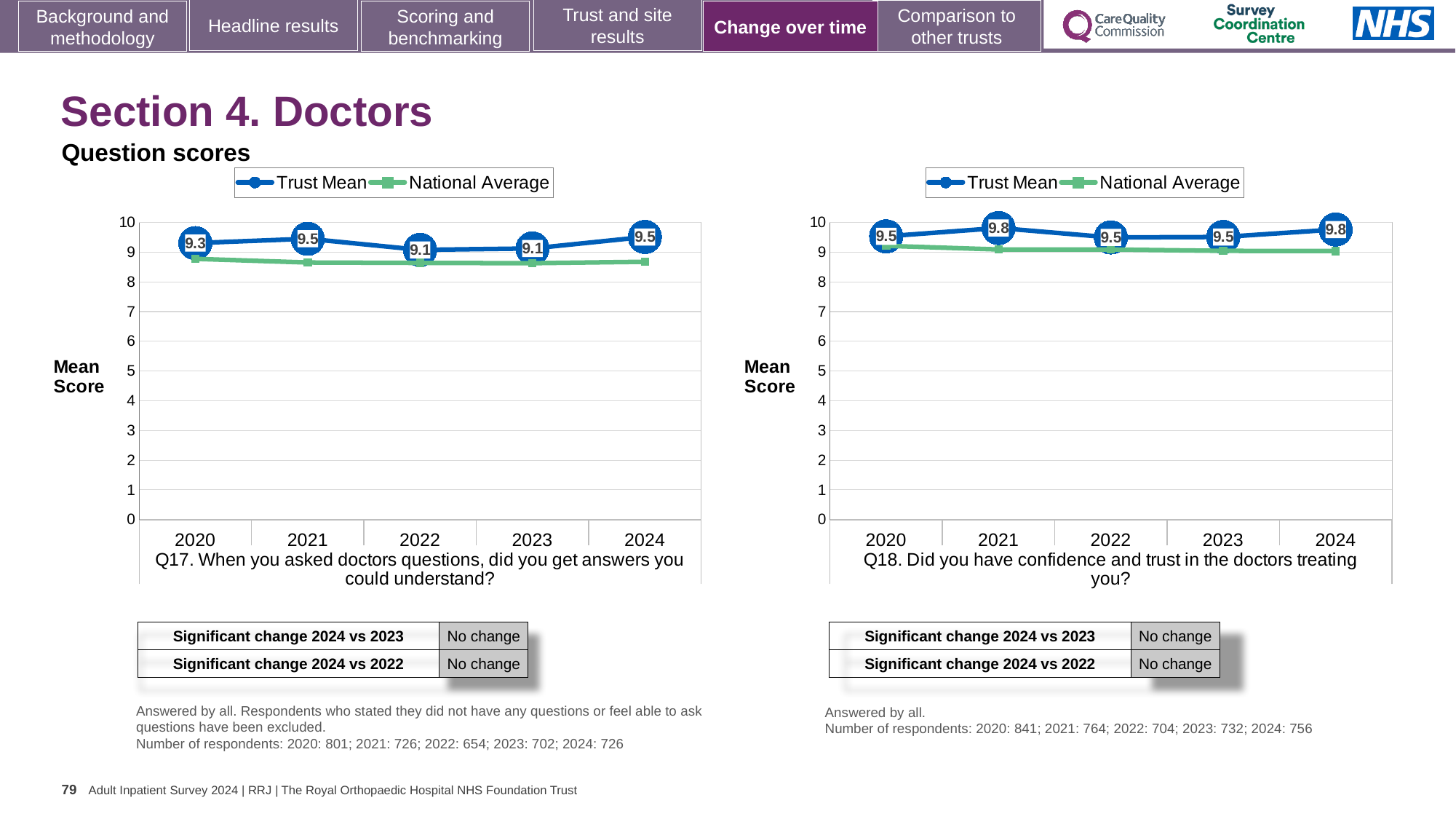
In the Q17 chart on the left, what is the Trust Mean score for 2022? 9.1 How many years are plotted on the x axis of the Q17 chart on the left? 5 In the Q17 chart on the left, which year has the larger Trust Mean score, 2021 or 2023? 2021 In the Q17 chart on the left, does the Trust Mean rise or fall from 2023 to 2024? Rise In the Q17 chart on the left, what is the Trust Mean score for 2020? 9.3 In the Q18 chart on the right, is the National Average value for 2020 greater or less than 8? greater How many series does the legend of the Q18 chart on the right list? 2 In the Q18 chart on the right, what is the difference between the Trust Mean scores for 2024 and 2022? 0.3 What kind of chart is the Q17 chart on the left? Line chart In the Q17 chart on the left, what is the difference between the Trust Mean scores for 2021 and 2022? 0.4 In the Q18 chart on the right, what is the Trust Mean score for 2021? 9.8 In the Q18 chart on the right, what is the Trust Mean score for 2023? 9.5